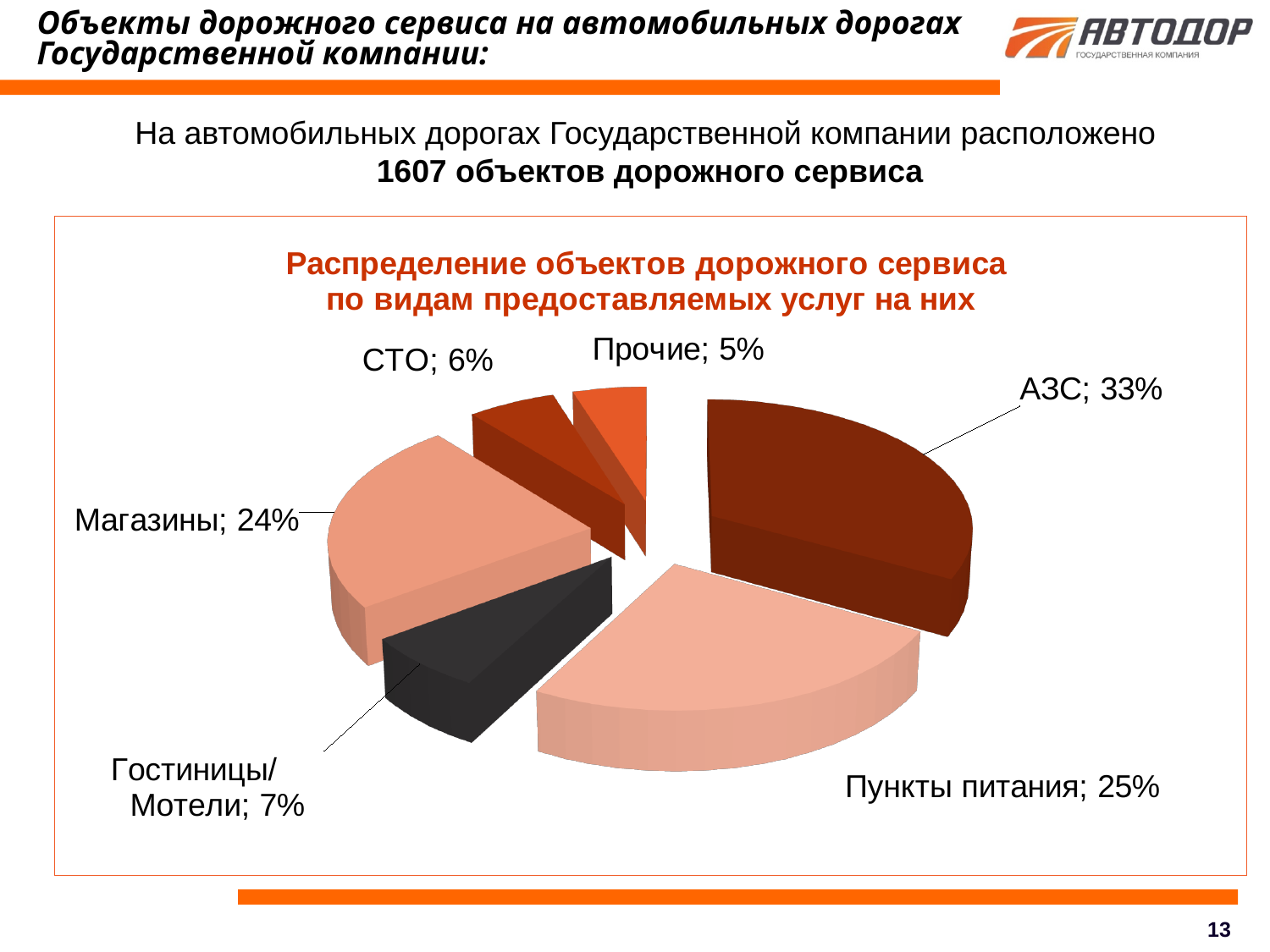
Which is larger, the share for Пункты питания or the share for Магазины? Пункты питания Which category has the largest share of the pie? АЗС What share of road service facilities is Магазины? 24% What is the difference in percentage points between АЗС and Магазины? 9 What share of road service facilities is АЗС? 33% What share of road service facilities is СТО? 6% How many categories are shown in the pie chart? 6 What kind of chart is shown on the slide? pie chart What share of road service facilities is Гостиницы/Мотели? 7% Which category has the smallest share of the pie? Прочие What share of road service facilities is Пункты питания? 25% What is the title of the chart? Распределение объектов дорожного сервиса по видам предоставляемых услуг на них